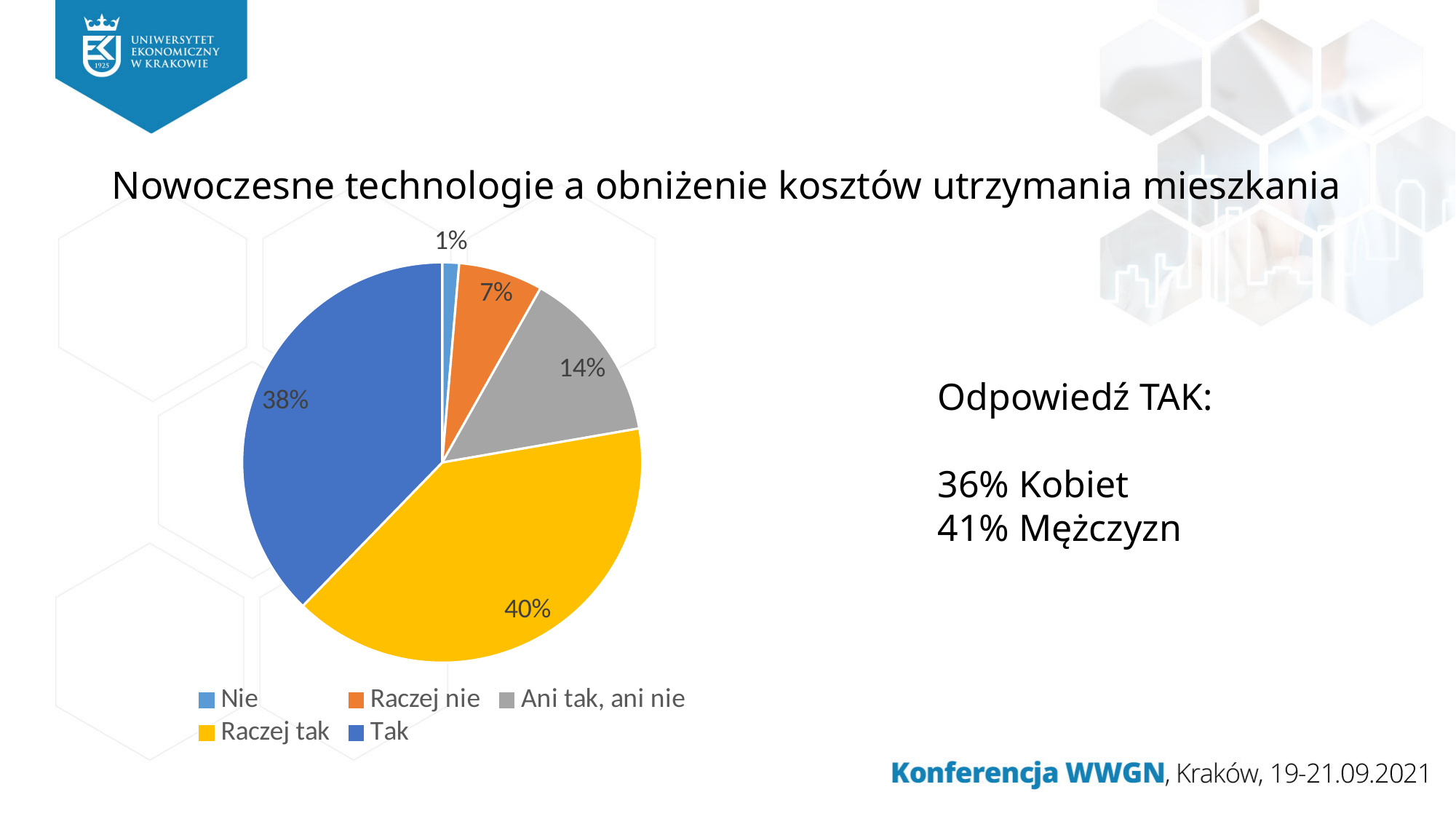
What percentage of the pie is the "Ani tak, ani nie" slice? 14% What percentage of the pie is the "Raczej nie" slice? 7% What kind of chart is shown on the slide? pie chart Which slice is larger, "Ani tak, ani nie" or "Raczej nie"? Ani tak, ani nie What is the title of the chart on the slide? Nowoczesne technologie a obniżenie kosztów utrzymania mieszkania What percentage of the pie is the "Raczej tak" slice? 40% What percentage of the pie is the "Nie" slice? 1% Which category has the largest slice of the pie? Raczej tak Which category has the smallest slice of the pie? Nie What percentage of the pie is the "Tak" slice? 38% How many categories does the legend of the pie chart list? 5 What is the difference in percentage points between the "Raczej tak" and "Tak" slices? 2